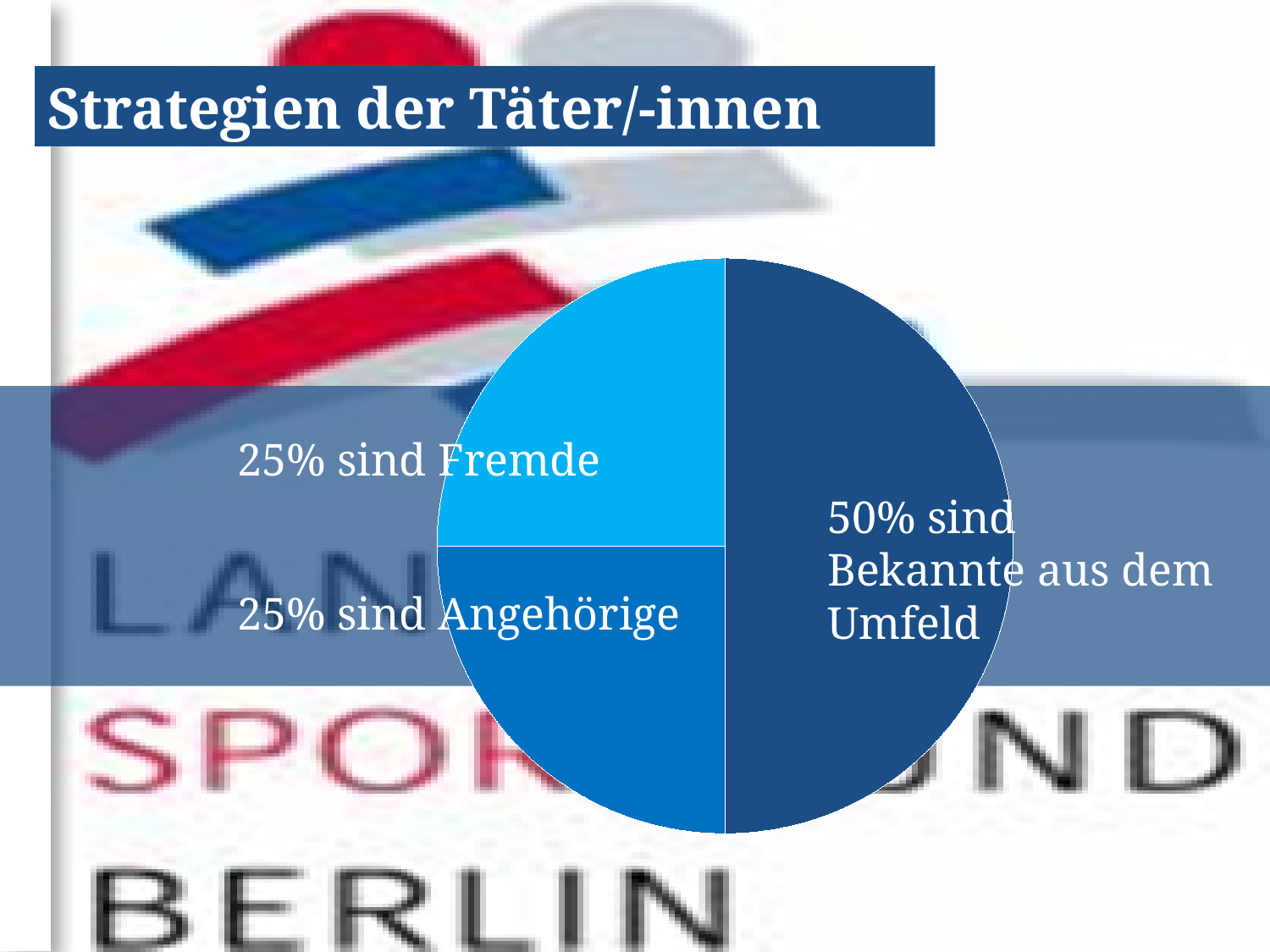
What share of the pie is labelled "Fremde"? 25% What is the difference in percentage points between the "Bekannte aus dem Umfeld" slice and the "Fremde" slice? 25 What share of the pie is labelled "Bekannte aus dem Umfeld"? 50% What is the combined share of the "Fremde" and "Angehörige" slices? 50% What kind of chart is shown on the slide? pie chart What share of the pie is labelled "Angehörige"? 25% Which group has the largest slice of the pie? Bekannte aus dem Umfeld How many slices does the pie chart have? 3 What is the title shown at the top of the slide? Strategien der Täter/-innen Which slice is larger, "Bekannte aus dem Umfeld" or "Angehörige"? Bekannte aus dem Umfeld Which slice of the pie is coloured the darkest blue? Bekannte aus dem Umfeld